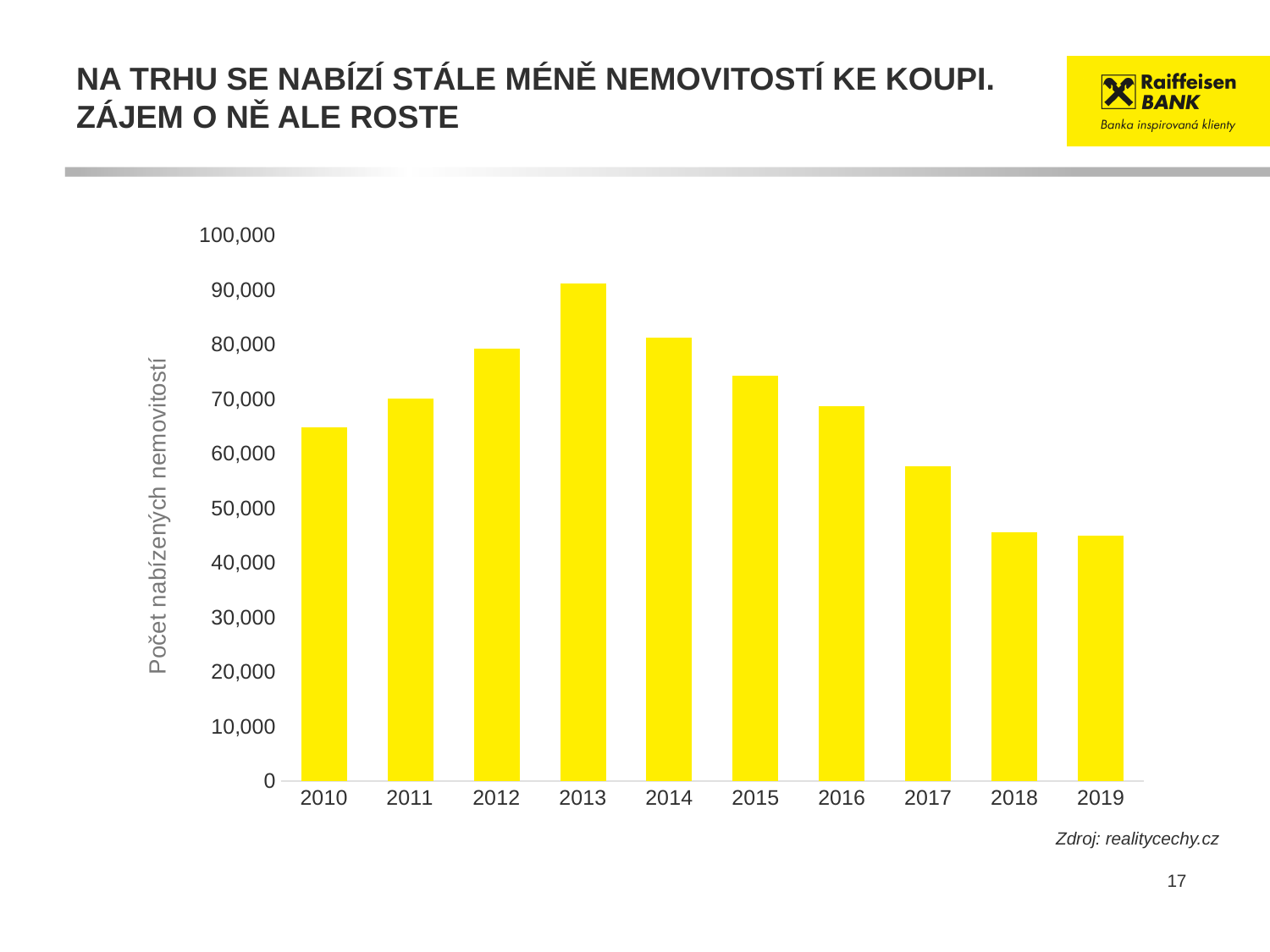
Is the value for 2018 greater or less than 50,000? less Is the value for 2010 greater or less than 60,000? greater Which is larger, the value for 2012 or the value for 2016? 2012 How many years are shown on the x axis of the chart? 10 Do the values rise or fall from 2013 to 2019? fall What kind of chart is shown on the slide? bar chart Is the value for 2014 greater or less than 80,000? greater What is the label of the vertical axis of the chart? Počet nabízených nemovitostí Which is larger, the value for 2015 or the value for 2011? 2015 Which year has the highest number of offered properties? 2013